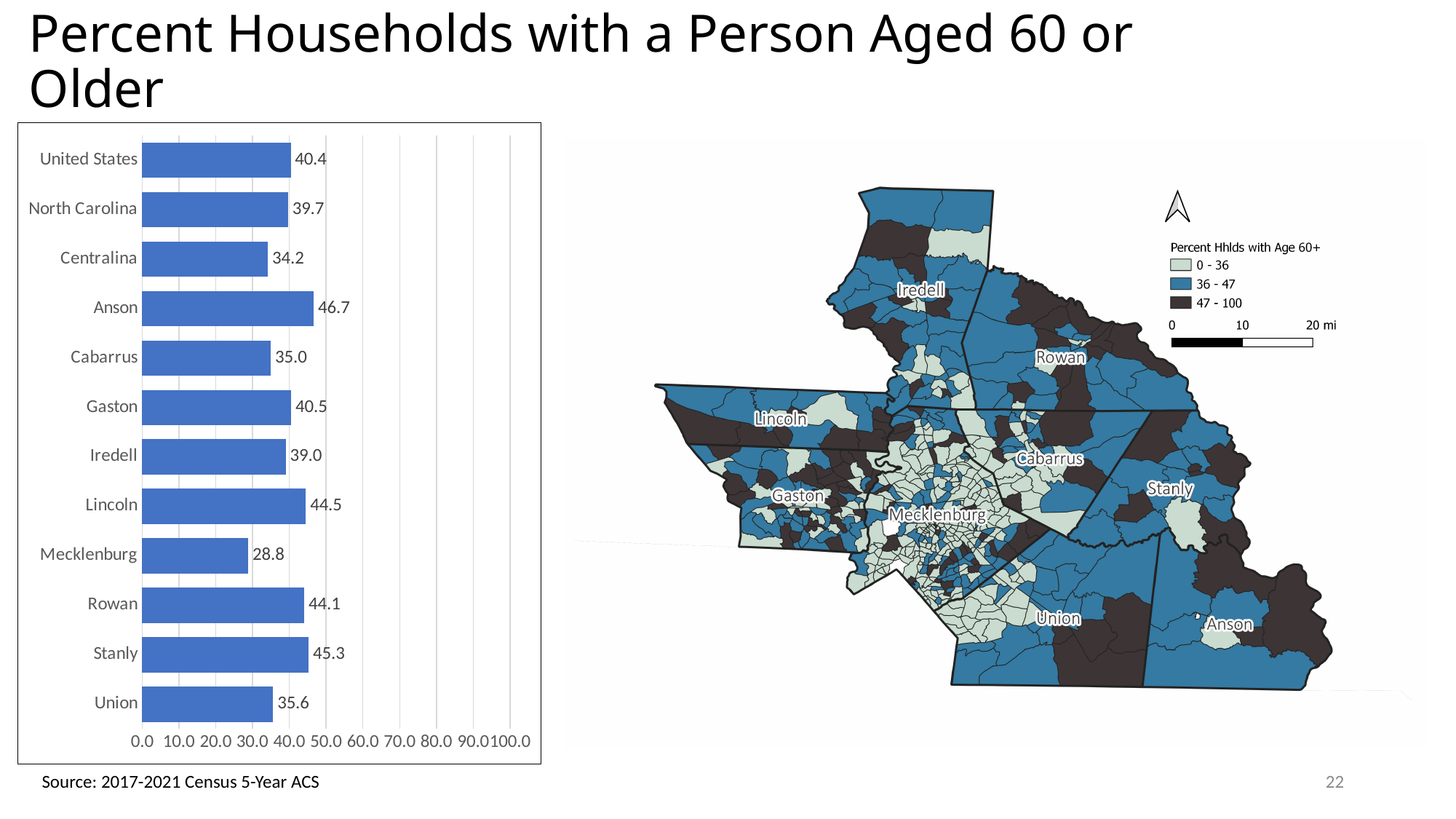
What is the value for North Carolina in the bar chart? 39.7 How many categories are shown in the bar chart? 12 Which has a larger value in the bar chart, Stanly or Rowan? Stanly Is the value for Union in the bar chart greater or less than 40.0? less What is the difference between the values for Anson and Mecklenburg in the bar chart? 17.9 What kind of chart is shown on the left of the slide? bar chart What is the value for Mecklenburg in the bar chart? 28.8 What is the source cited below the bar chart? 2017-2021 Census 5-Year ACS Which category has the lowest value in the bar chart? Mecklenburg What is the difference between the values for United States and Centralina in the bar chart? 6.2 What is the value for Anson in the bar chart? 46.7 Which category has the highest value in the bar chart? Anson